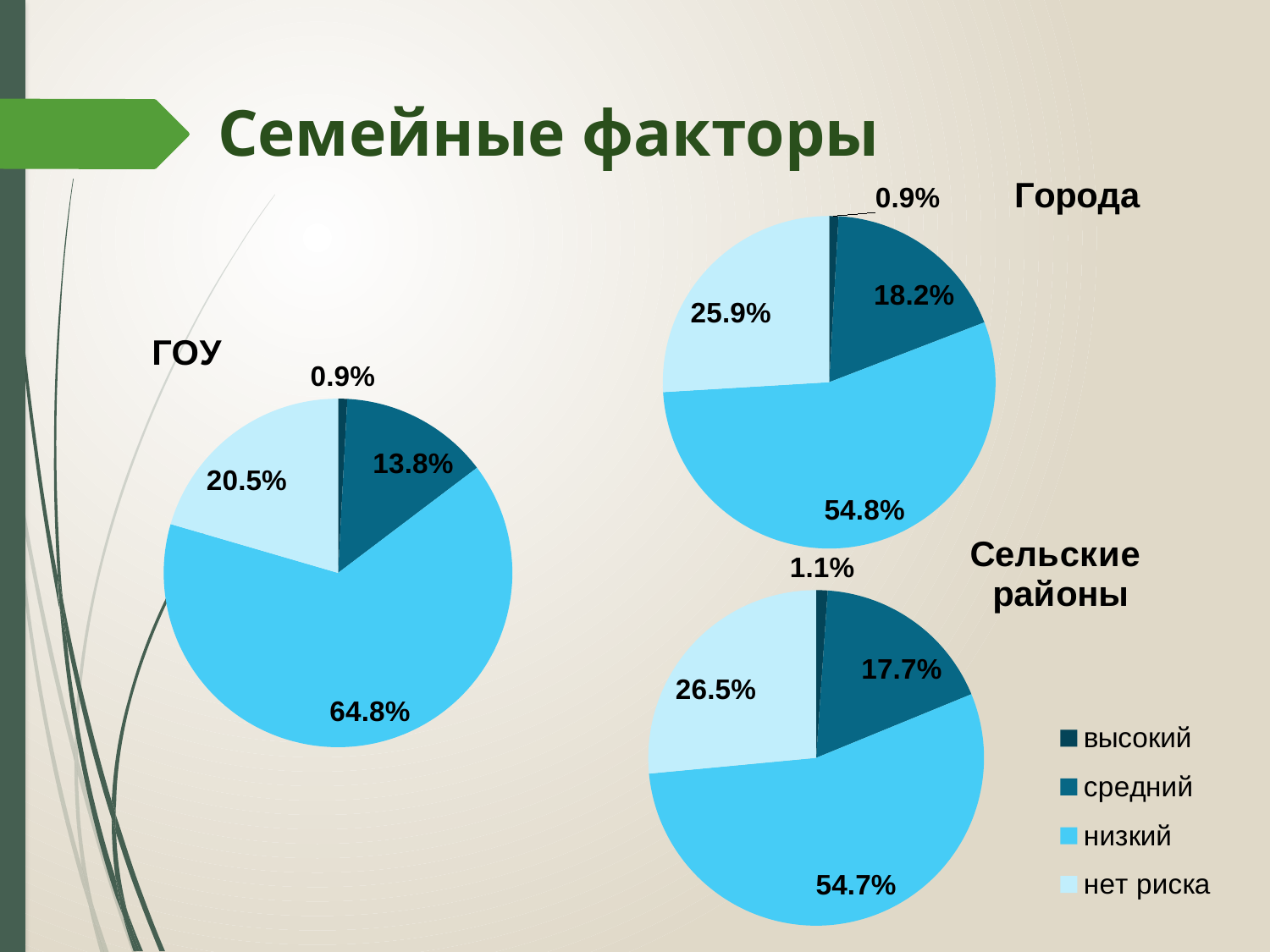
In the Сельские районы pie chart, what is the value for нет риска? 26.5% In the Сельские районы pie chart, what is the value for высокий? 1.1% How many entries does the legend list? 4 In the Сельские районы pie chart, what is the difference between the низкий and нет риска values? 28.2% In the Города pie chart, what is the value for средний? 18.2% What type of chart is used for Сельские районы? pie chart How many slices does the Города pie chart have? 4 In the ГОУ pie chart, what share does the низкий slice have? 64.8% In the Города pie chart, which category has the smallest slice? высокий How many pie charts are shown on the slide? 3 In the ГОУ pie chart, which category has the largest slice? низкий In the ГОУ pie chart, which is larger: средний or нет риска? нет риска